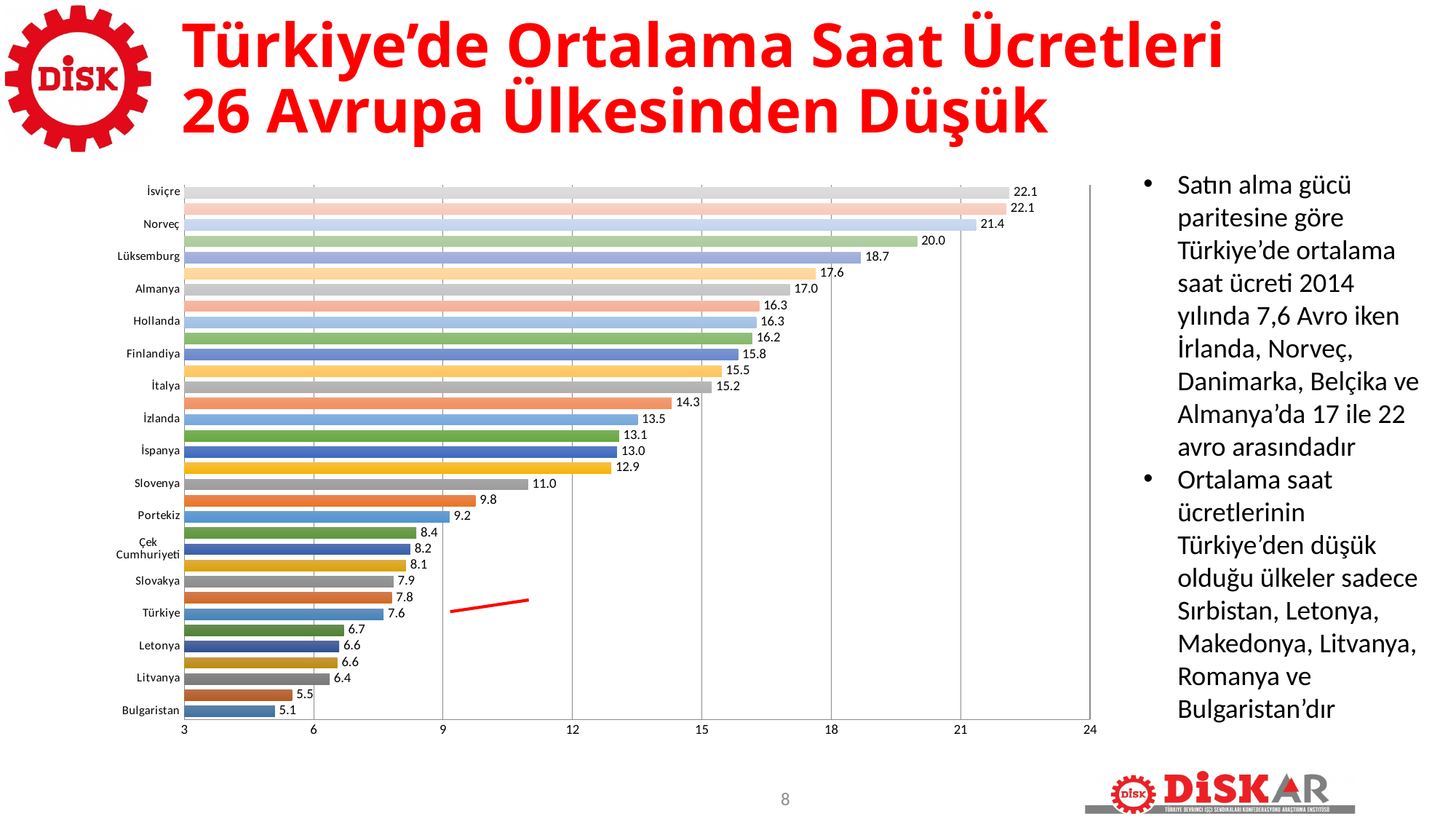
What is the value shown for Almanya? 17.0 Do the bar values increase or decrease going from the top of the chart to the bottom? decrease What is the value shown for Slovenya? 11.0 What kind of chart is shown on the slide? bar chart What is the value shown for Bulgaristan? 5.1 What is the value shown for Norveç? 21.4 Which has a larger value, Hollanda or Finlandiya? Hollanda How many bars are plotted in the chart? 33 Is the value for Portekiz greater or less than 12? less What is the value shown for Türkiye? 7.6 Which labelled country has the lowest value in the chart? Bulgaristan What is the difference between the values for Almanya and Türkiye? 9.4